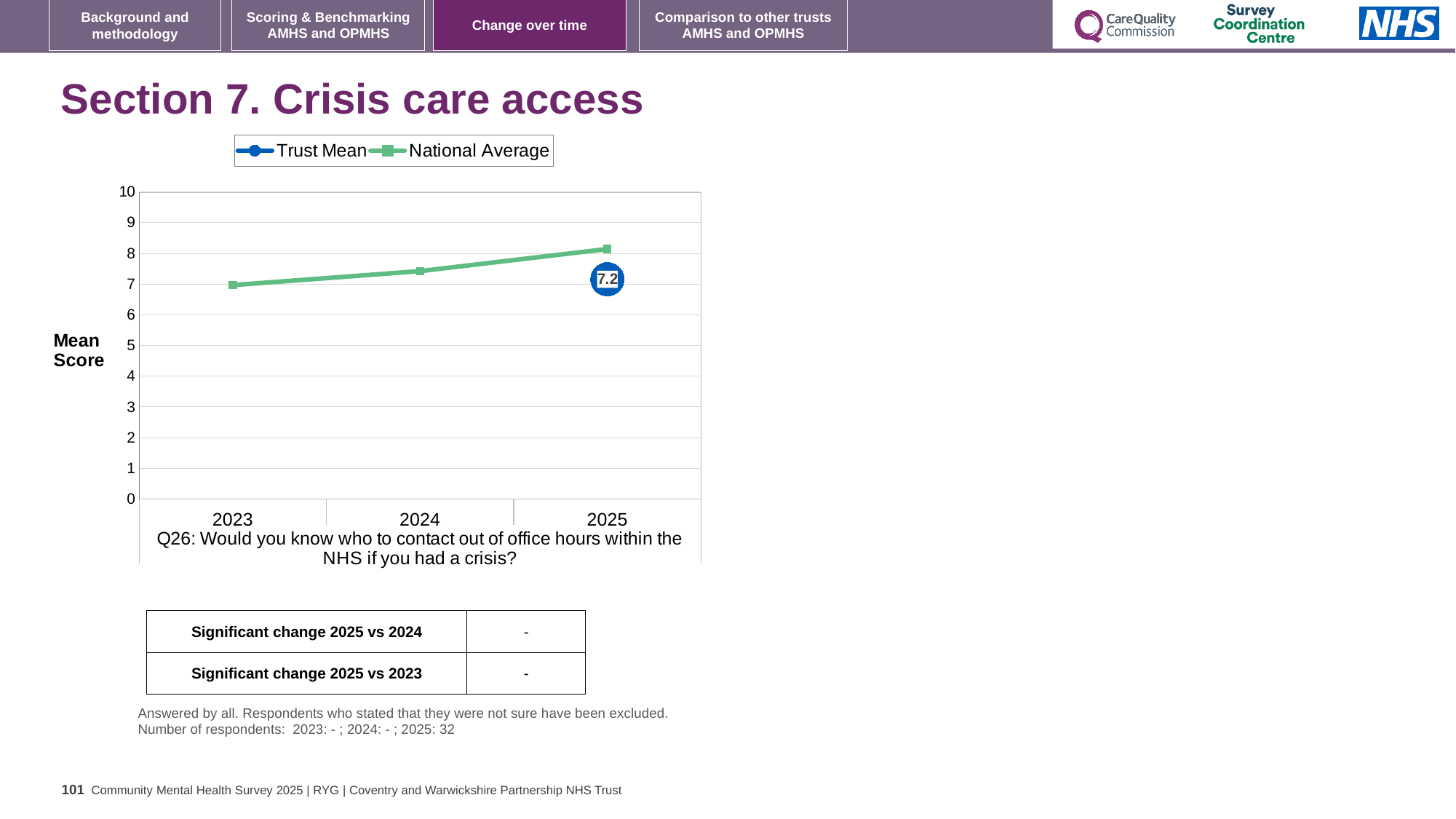
In which year is the National Average highest? 2025 Is the National Average value for 2024 greater or less than 8? less In which year is the National Average lowest? 2023 What is the Trust Mean value shown for 2025? 7.2 Does the National Average rise or fall from 2023 to 2025? Rise How many years are shown on the x axis? 3 What kind of chart is shown on the slide? Line chart Is the National Average value for 2023 greater or less than 6? greater Is the National Average value for 2025 greater or less than 7? greater What is the label on the y axis of the chart? Mean Score In 2025, which is higher: the Trust Mean or the National Average? National Average How many series does the legend list? 2